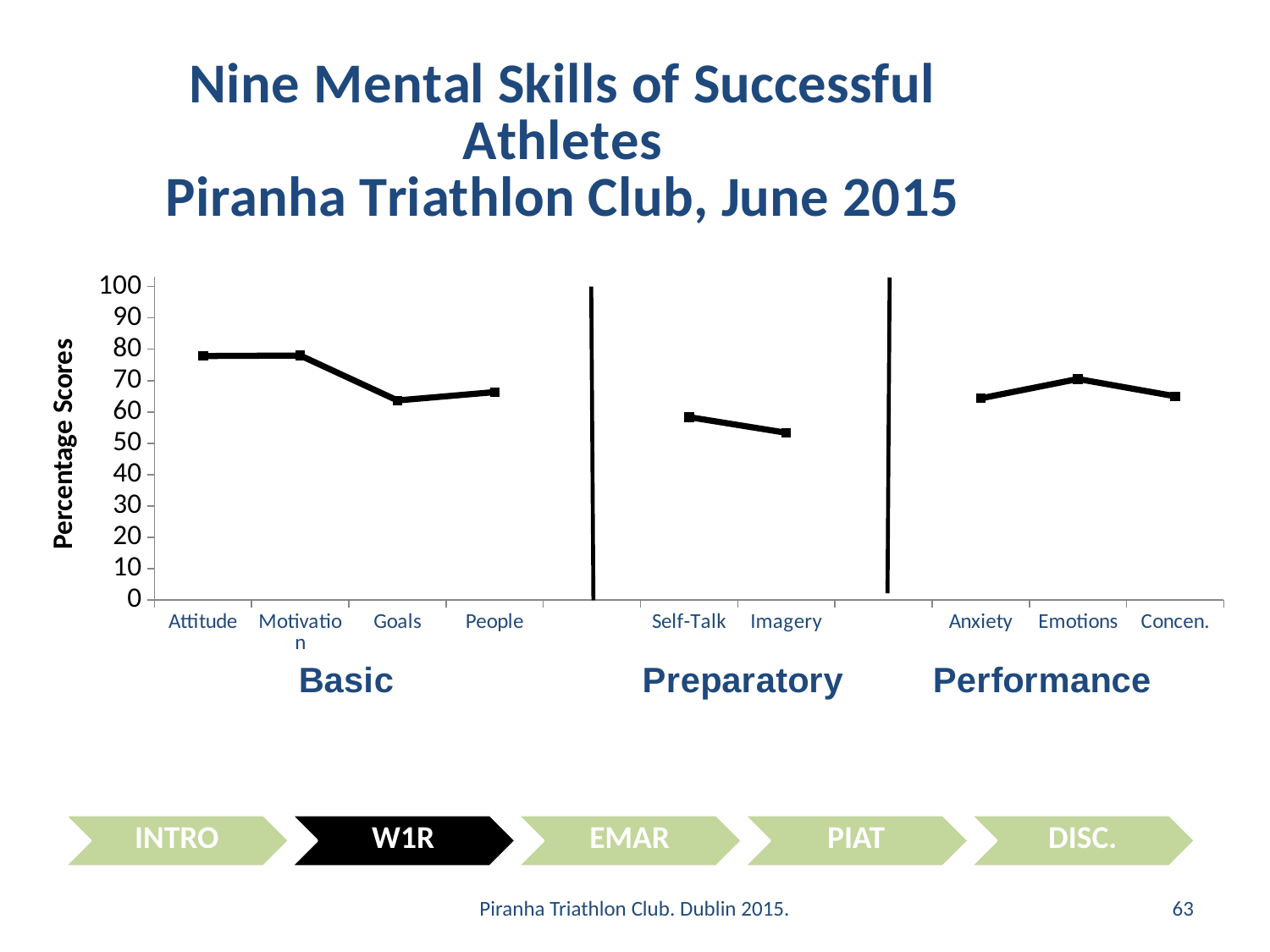
Is the value for Goals greater or less than 70? less Is the value for Imagery greater or less than 60? less What are the three group labels shown beneath the x axis? Basic, Preparatory, Performance Which category has the lowest percentage score? Imagery Is the value for Attitude greater or less than 70? greater Which has the higher percentage score, Attitude or Goals? Attitude What is the title of the vertical axis? Percentage Scores How many mental skills (categories) are plotted on the x axis? 9 Which has the higher percentage score, Imagery or Emotions? Emotions Within the Preparatory group, do the values rise or fall from Self-Talk to Imagery? fall What kind of chart is shown on the slide? line chart